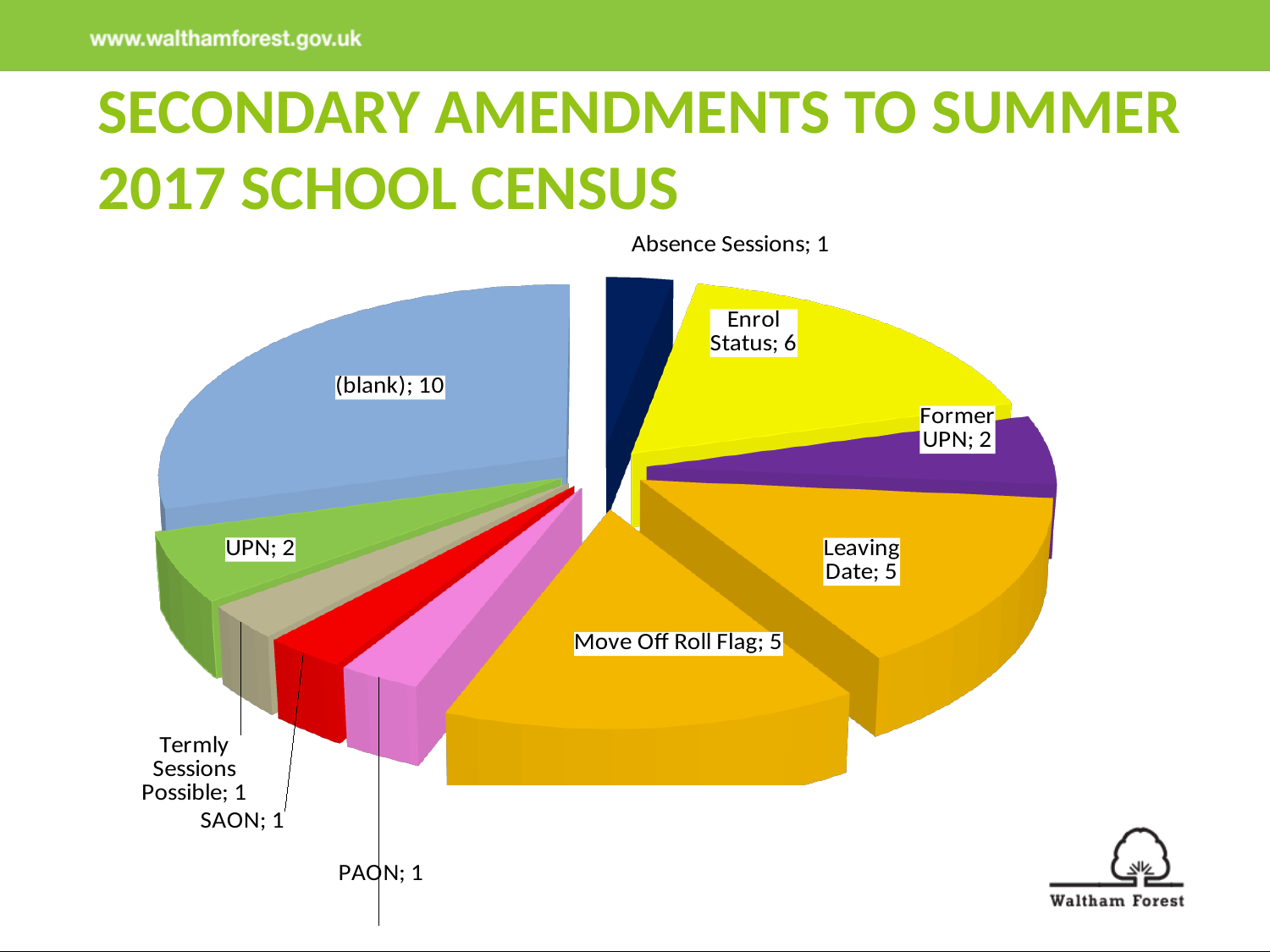
What is the total of all the slice values in the pie chart? 34 What is the title of the slide containing the chart? SECONDARY AMENDMENTS TO SUMMER 2017 SCHOOL CENSUS What type of chart is shown on the slide? Pie chart What is the value for (blank)? 10 Which is larger, the value for Enrol Status or the value for Move Off Roll Flag? Enrol Status What is the value for Enrol Status? 6 What is the value for Former UPN? 2 What is the value for Leaving Date? 5 How many categories (slices) does the pie chart have? 10 What is the difference between the values for (blank) and Enrol Status? 4 Which category has the largest slice? (blank) What is the value for Termly Sessions Possible? 1